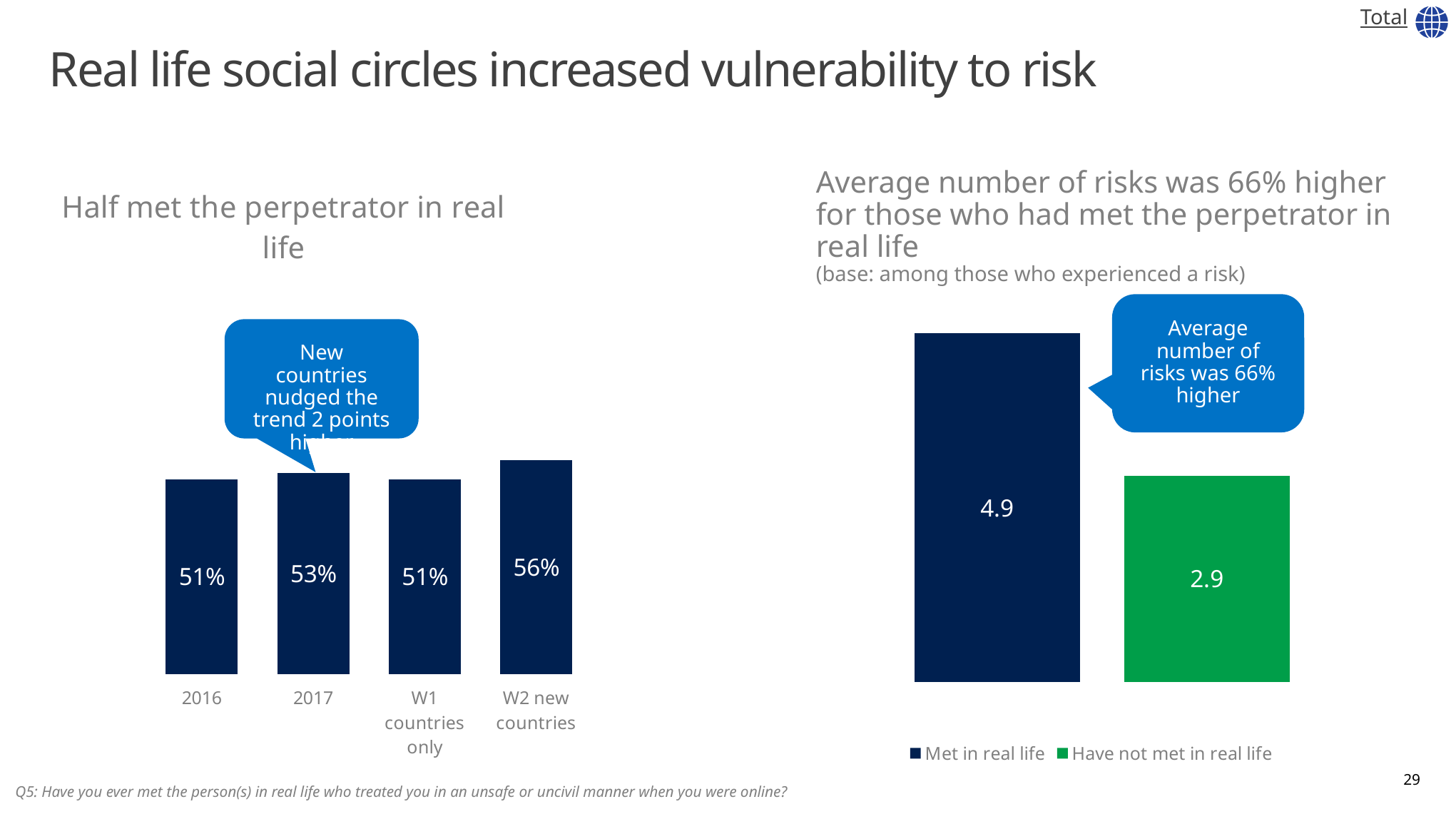
In the left chart 'Half met the perpetrator in real life', how many categories are shown? 4 In the left chart 'Half met the perpetrator in real life', what is the value for 2017? 53% How many series does the legend of the right chart list? 2 What kind of chart is the left chart 'Half met the perpetrator in real life'? bar chart In the left chart 'Half met the perpetrator in real life', is the value for 2017 larger or smaller than the value for W1 countries only? larger In the left chart 'Half met the perpetrator in real life', what is the difference between the W2 new countries value and the 2016 value? 5 percentage points In the right chart, what is the difference between the 'Met in real life' and 'Have not met in real life' values? 2.0 In the right chart, what is the average number of risks for those who met the perpetrator in real life? 4.9 In the right chart, what is the average number of risks for those who have not met the perpetrator in real life? 2.9 In the left chart 'Half met the perpetrator in real life', which category has the highest value? W2 new countries In the right chart, what colour is the 'Have not met in real life' bar? green In the left chart 'Half met the perpetrator in real life', what is the value for W2 new countries? 56%